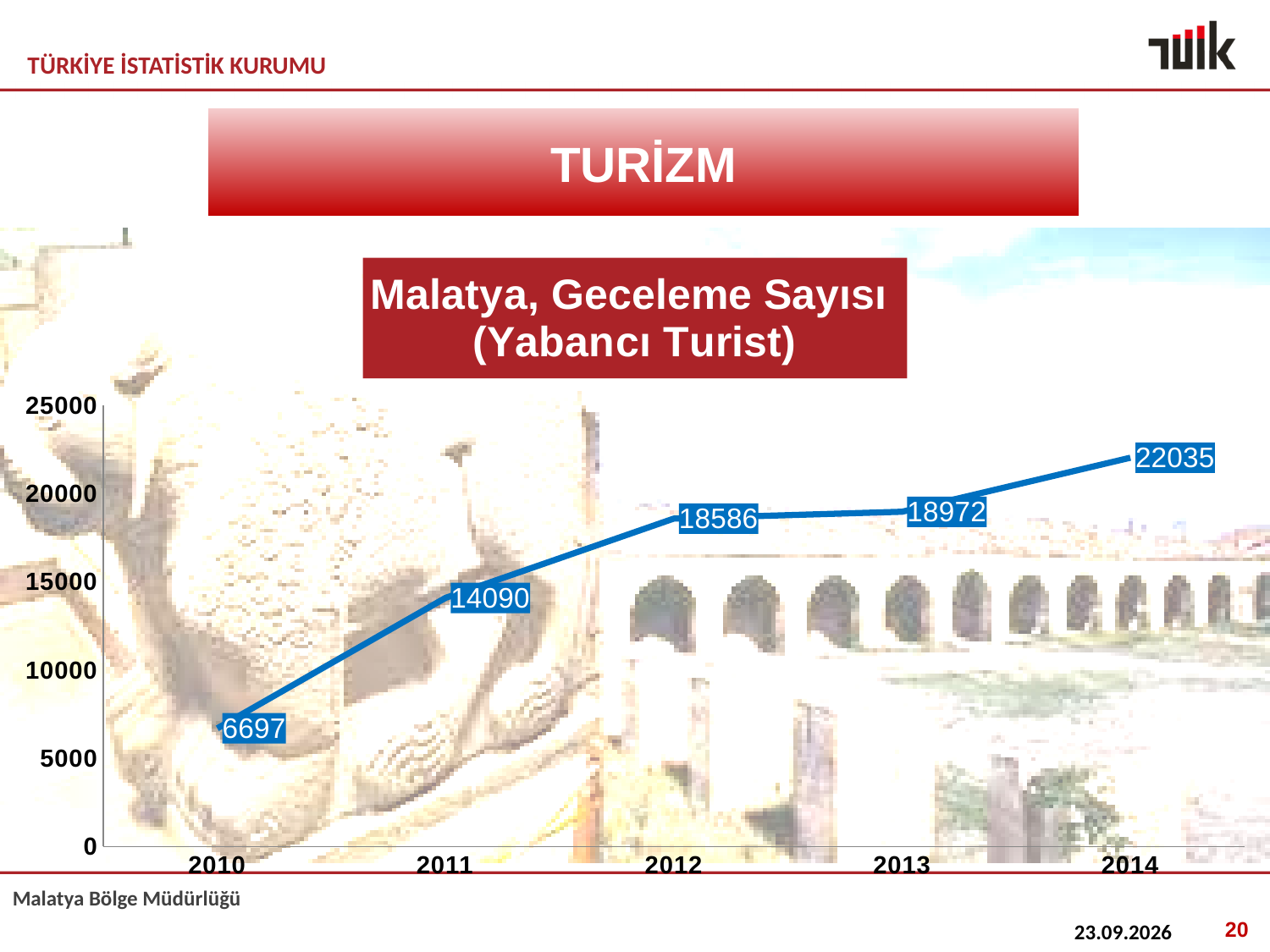
Is the value for 2013 greater or less than 20000? less Which year has the lowest value? 2010 What is the difference between the values for 2014 and 2013? 3063 What is the value for 2012? 18586 What is the value for 2010? 6697 Which is larger, the value for 2011 or the value for 2012? 2012 Which year has the highest value? 2014 What is the difference between the values for 2011 and 2010? 7393 Do the values rise or fall from 2010 to 2014? rise How many years are plotted on the chart? 5 What kind of chart is shown? line chart What is the value for 2014? 22035